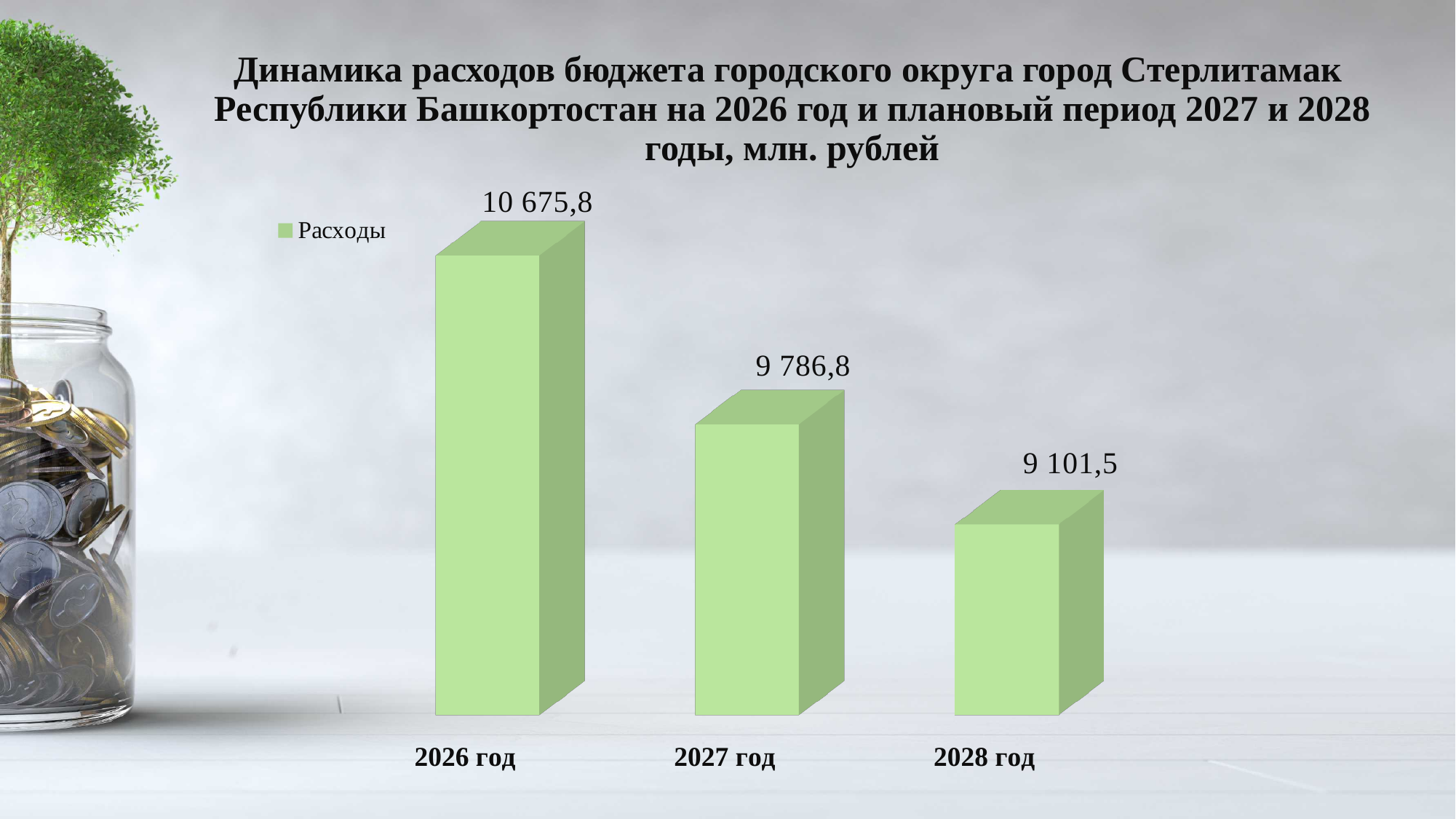
What is the value for 2027 год? 9 786,8 Do the values rise or fall from 2026 год to 2028 год? fall What is the value for 2026 год? 10 675,8 What kind of chart is shown on the slide? bar chart What is the value for 2028 год? 9 101,5 Which is larger, the value for 2027 год or the value for 2028 год? 2027 год How many series does the legend list? 1 What is the difference between the values for 2027 год and 2028 год? 685,3 Which year has the lowest value? 2028 год How many years are shown on the chart? 3 Which year has the highest value? 2026 год What is the difference between the values for 2026 год and 2027 год? 889,0